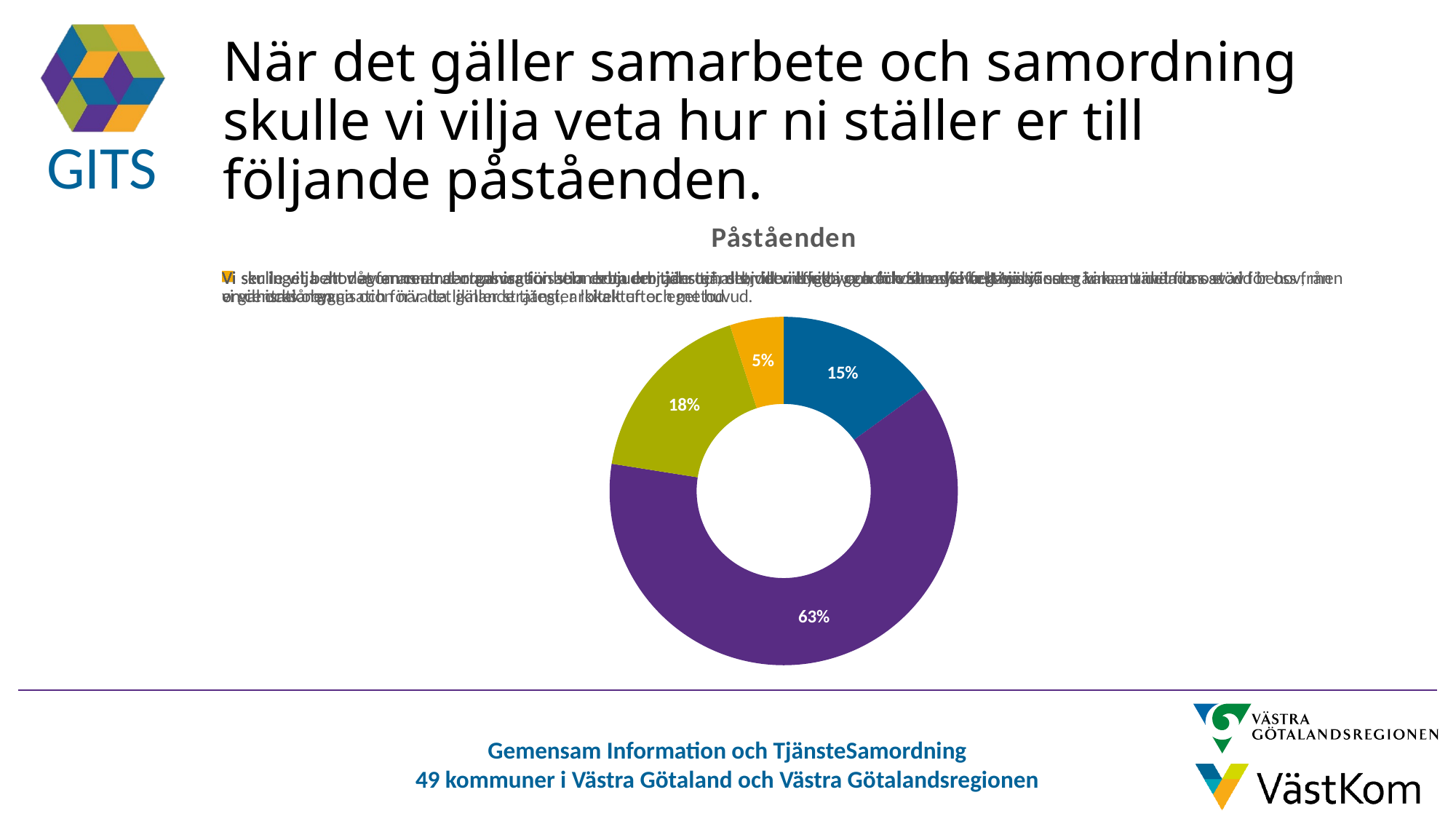
What colour is the largest slice of the doughnut chart? Purple How many slices does the doughnut chart have? 4 What percentage is shown on the purple slice? 63% What is the largest slice's share of the doughnut chart? 63% What is the title of the chart? Påståenden What is the difference in percentage points between the purple slice and the olive-green slice? 45 percentage points What kind of chart is shown on the slide? Doughnut (pie) chart What is the smallest slice's share of the doughnut chart? 5% Which slice is larger, the blue one or the olive-green one? The olive-green one (18%) What percentage is shown on the orange slice? 5% What percentage is shown on the blue slice? 15% What percentage is shown on the olive-green slice? 18%